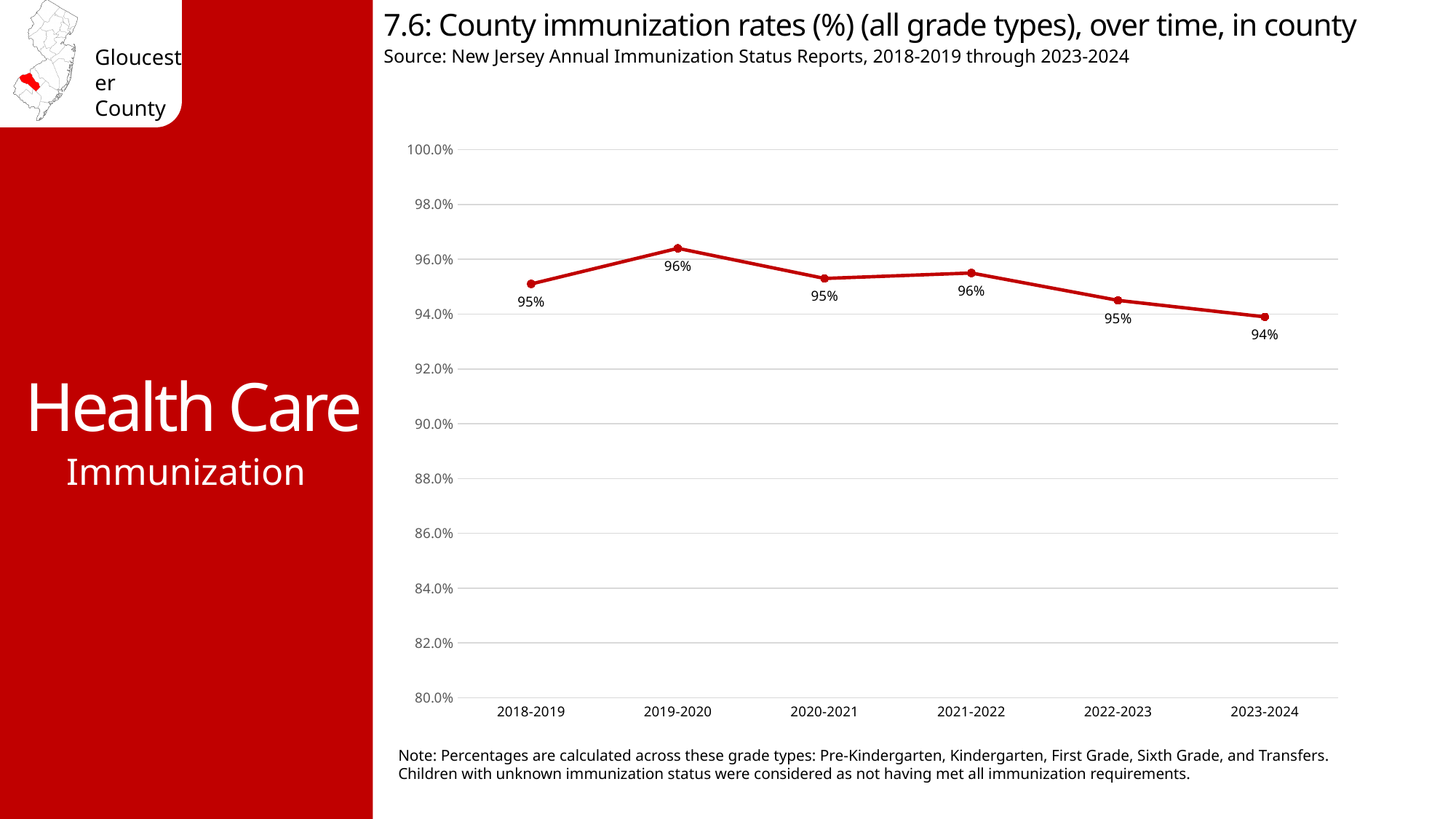
Does the immunization rate rise or fall from 2021-2022 to 2023-2024? Fall Which school year has the highest immunization rate? 2019-2020 Which is larger, the immunization rate for 2018-2019 or for 2023-2024? 2018-2019 How many school years are plotted on the chart? 6 Which school year has the lowest immunization rate? 2023-2024 What is the county immunization rate for 2019-2020? 96% What is the county immunization rate for 2022-2023? 95% What is the difference between the labelled immunization rates for 2019-2020 and 2023-2024? 2 percentage points What type of chart is shown on the slide? Line chart What is the county immunization rate for 2018-2019? 95% What is the county immunization rate for 2023-2024? 94% Is the immunization rate for 2022-2023 greater or less than 94.0%? greater